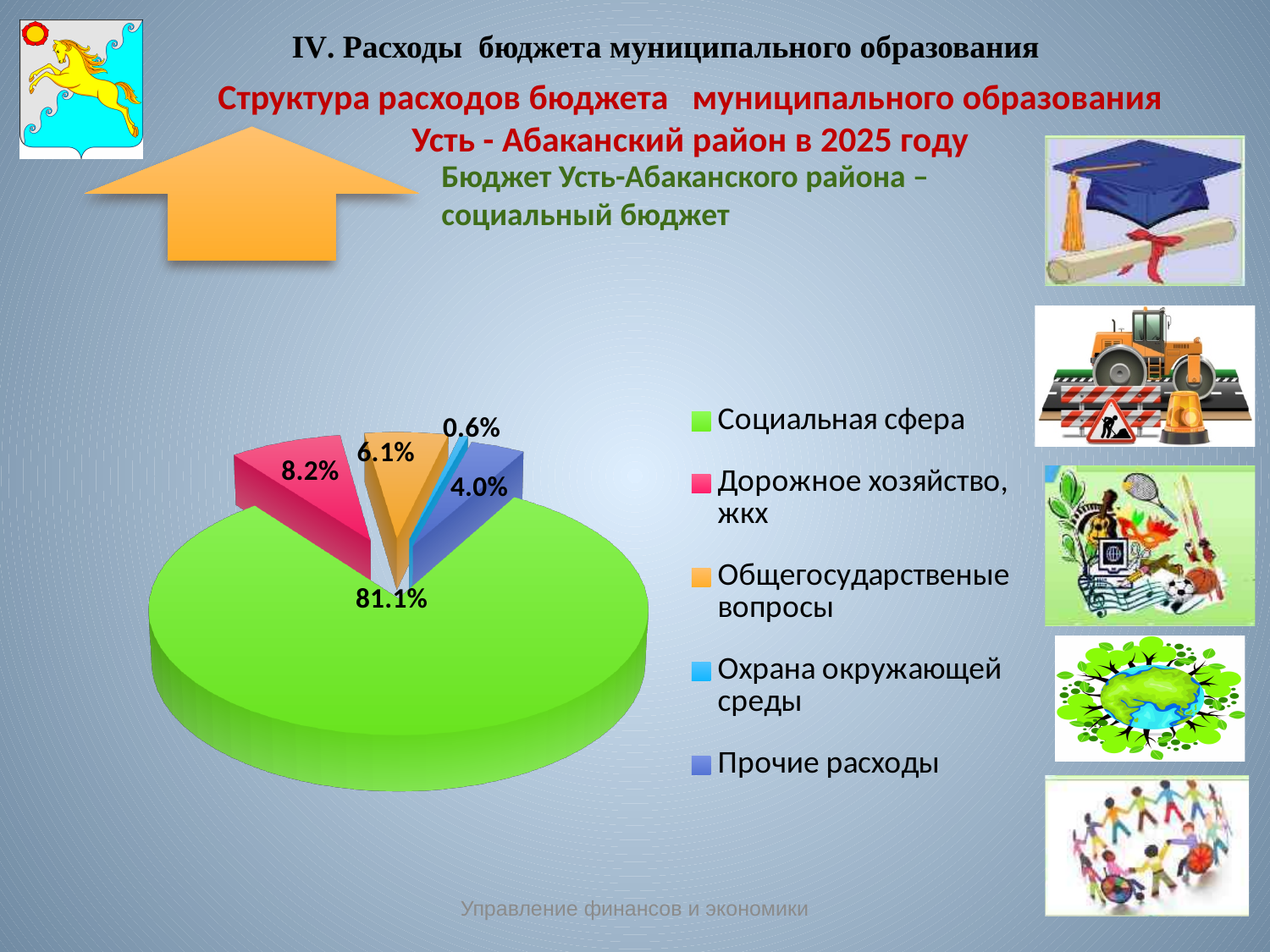
What kind of chart is shown on the slide? Pie chart What colour is the slice for Социальная сфера? Green What is the value shown for Охрана окружающей среды? 0.6% How many categories does the pie chart show? 5 What is the value shown for Общегосударственые вопросы? 6.1% What is the value shown for Прочие расходы? 4.0% What is the value shown for Дорожное хозяйство, жкх? 8.2% What share of the pie does Социальная сфера have? 81.1% Which category has the smallest slice of the pie? Охрана окружающей среды What is the difference between the shares of Дорожное хозяйство, жкх and Прочие расходы? 4.2% Which is larger: Общегосударственые вопросы or Прочие расходы? Общегосударственые вопросы Which category has the largest slice of the pie? Социальная сфера